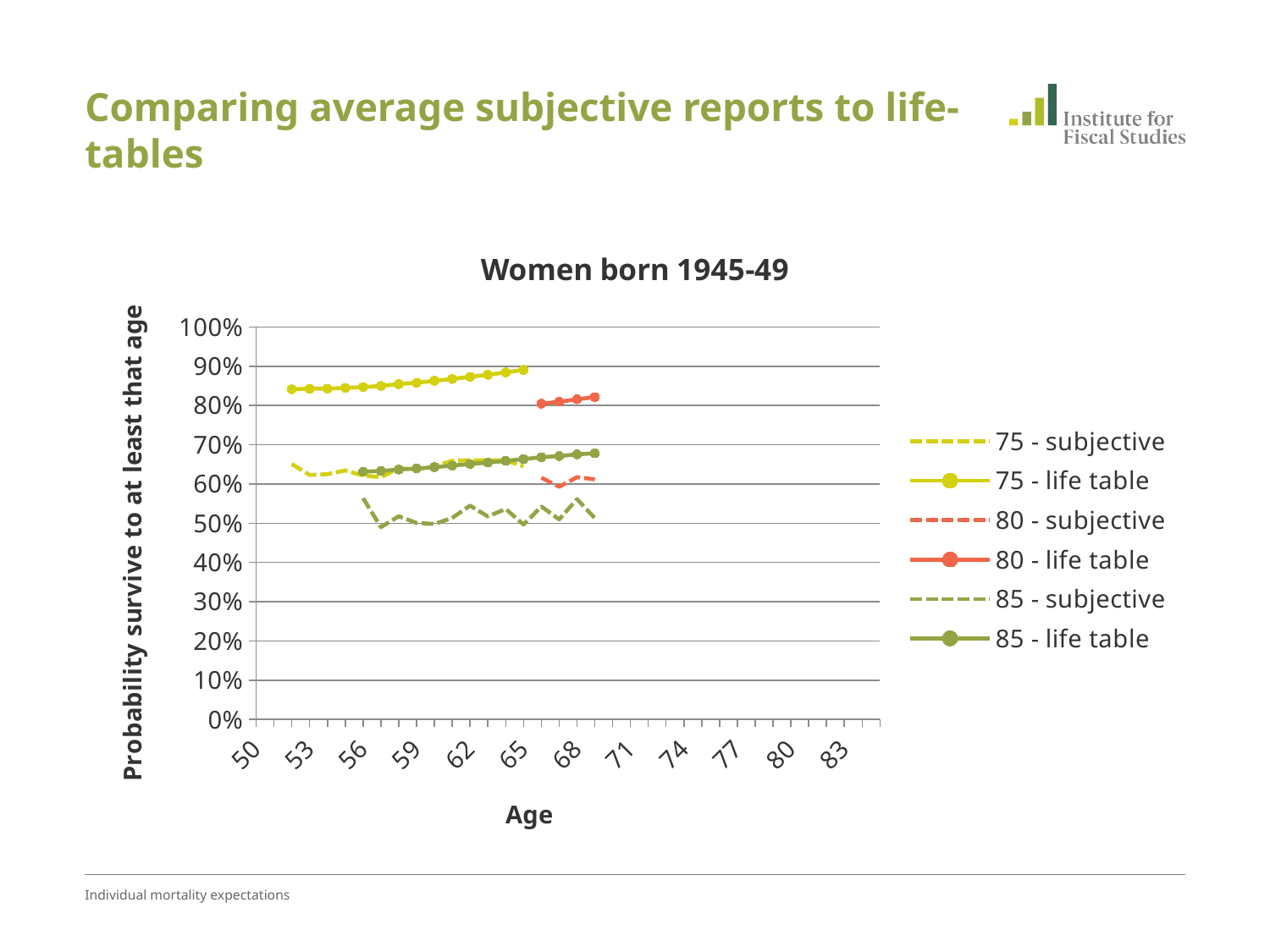
Is the value for the 80 - life table series at age 68 greater or less than 70%? greater Which series has the highest values on the chart? 75 - life table Is the value for the 85 - life table series at age 62 greater or less than 50%? greater What kind of chart is shown on the slide? line chart What is the label of the x axis? Age Does the 75 - life table series rise or fall as age increases? rise Is the value for the 75 - life table series at age 65 greater or less than 80%? greater What is the title of the chart? Women born 1945-49 At age 65, which is higher: the 75 - life table series or the 85 - life table series? 75 - life table How many series does the legend list? 6 Does the 85 - life table series rise or fall as age increases? rise